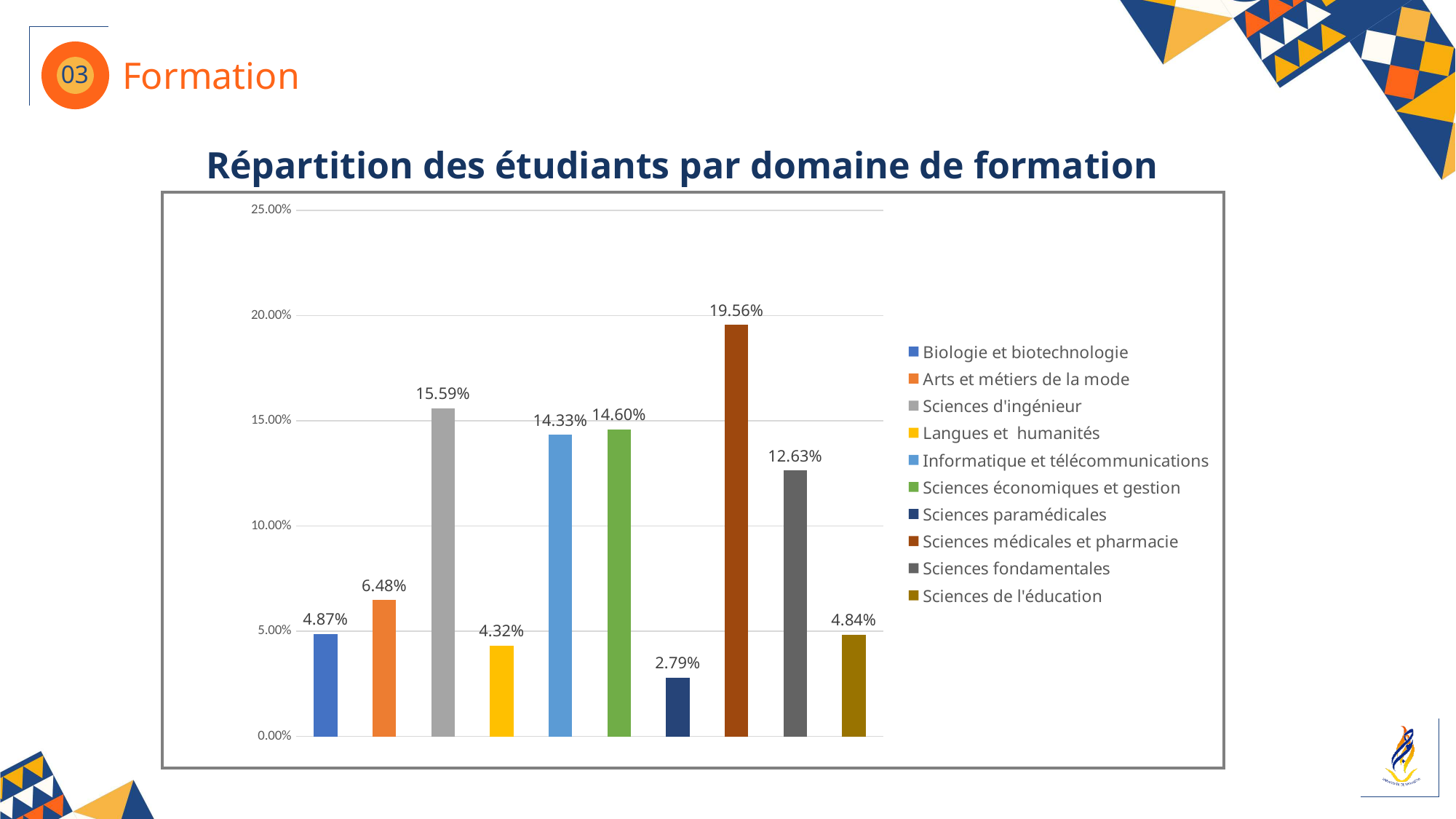
Which domain has the lowest share of students? Sciences paramédicales What is the difference between the values for Sciences d'ingénieur and Sciences fondamentales? 2.96% What is the value for Sciences médicales et pharmacie? 19.56% What is the title of the chart? Répartition des étudiants par domaine de formation What is the value for Sciences fondamentales? 12.63% How many series does the legend list? 10 Is the value for Informatique et télécommunications greater or less than 15.00%? less What kind of chart is shown on the slide? bar chart What is the value for Langues et humanités? 4.32% Which is larger, the value for Biologie et biotechnologie or the value for Arts et métiers de la mode? Arts et métiers de la mode Which domain has the highest share of students? Sciences médicales et pharmacie What is the difference between the values for Sciences économiques et gestion and Informatique et télécommunications? 0.27%